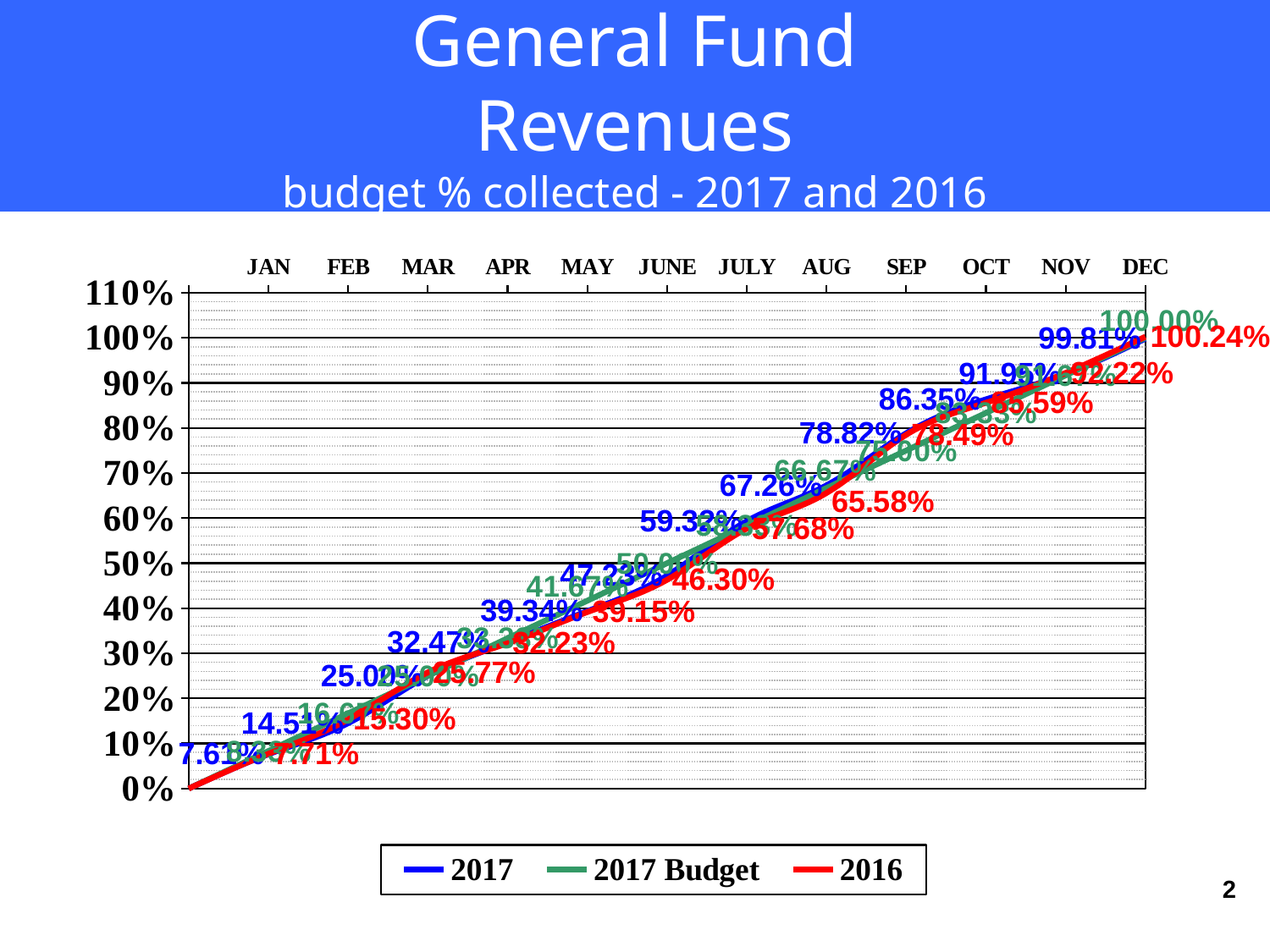
What is the 2016 value for DEC? 100.24% What is the 2016 value for AUG? 65.58% How many months are shown along the x axis? 12 How many series does the legend list? 3 What is the difference between the 2016 and 2017 values for DEC? 0.43% Which series is drawn in red according to the legend? 2016 Do the values for the 2017 series rise or fall from JAN to DEC? rise What is the 2017 value for SEP? 78.82% What kind of chart is shown on the slide? line chart What is the 2017 value for DEC? 99.81% Which is larger for JULY, the 2017 value or the 2016 value? 2017 What is the 2017 Budget value for DEC? 100.00%